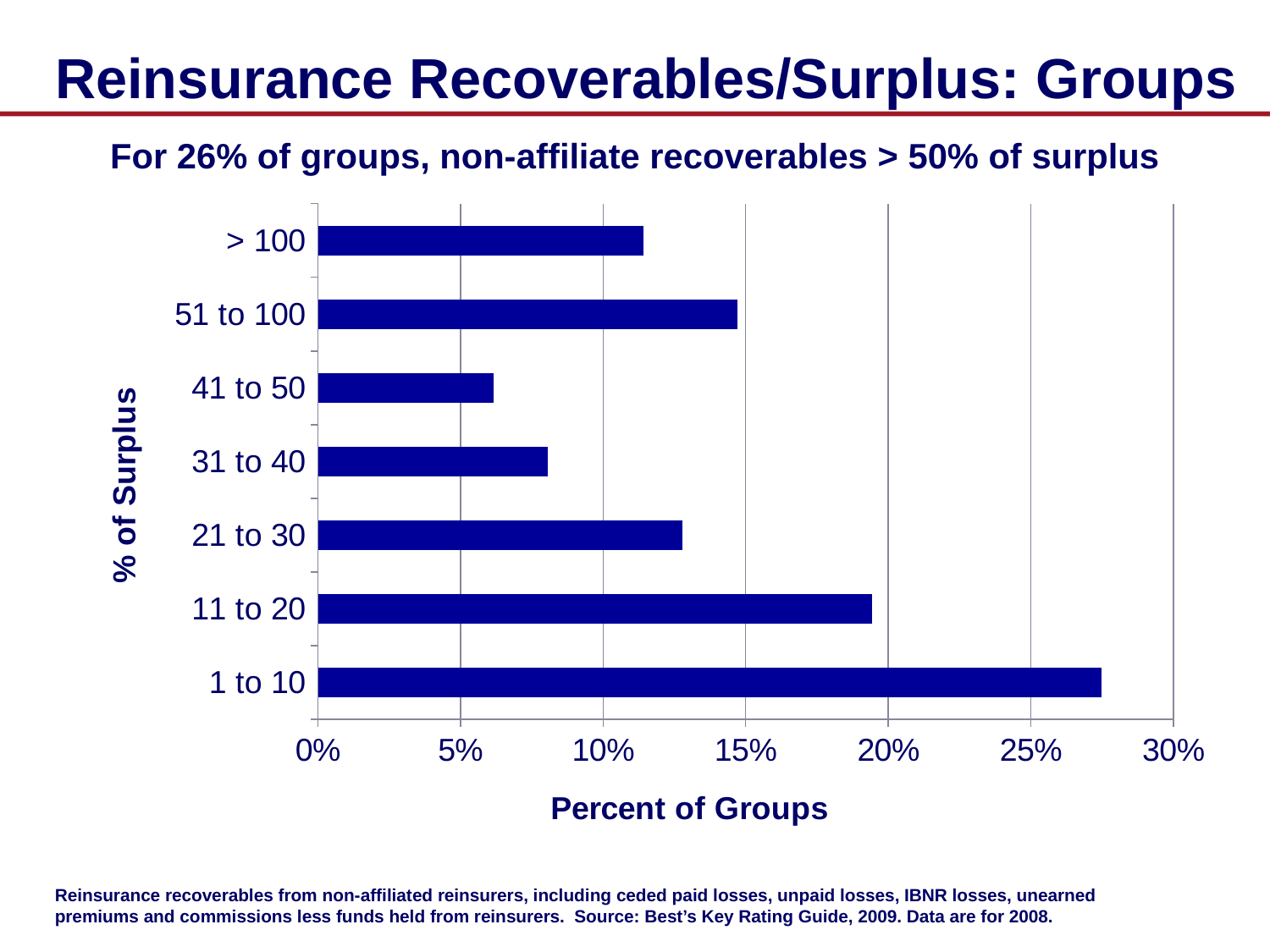
What is the label of the horizontal axis of the chart? Percent of Groups How many surplus categories are plotted in the chart? 7 Which is larger, the value for 11 to 20 or the value for > 100? 11 to 20 What kind of chart is shown on the slide? bar chart Is the value for the 31 to 40 category greater or less than 10%? less Is the value for the 41 to 50 category greater or less than 5%? greater Is the value for the 11 to 20 category greater or less than 20%? less Which is larger, the value for 51 to 100 or the value for 21 to 30? 51 to 100 Which category has the highest percent of groups? 1 to 10 Which category has the lowest percent of groups? 41 to 50